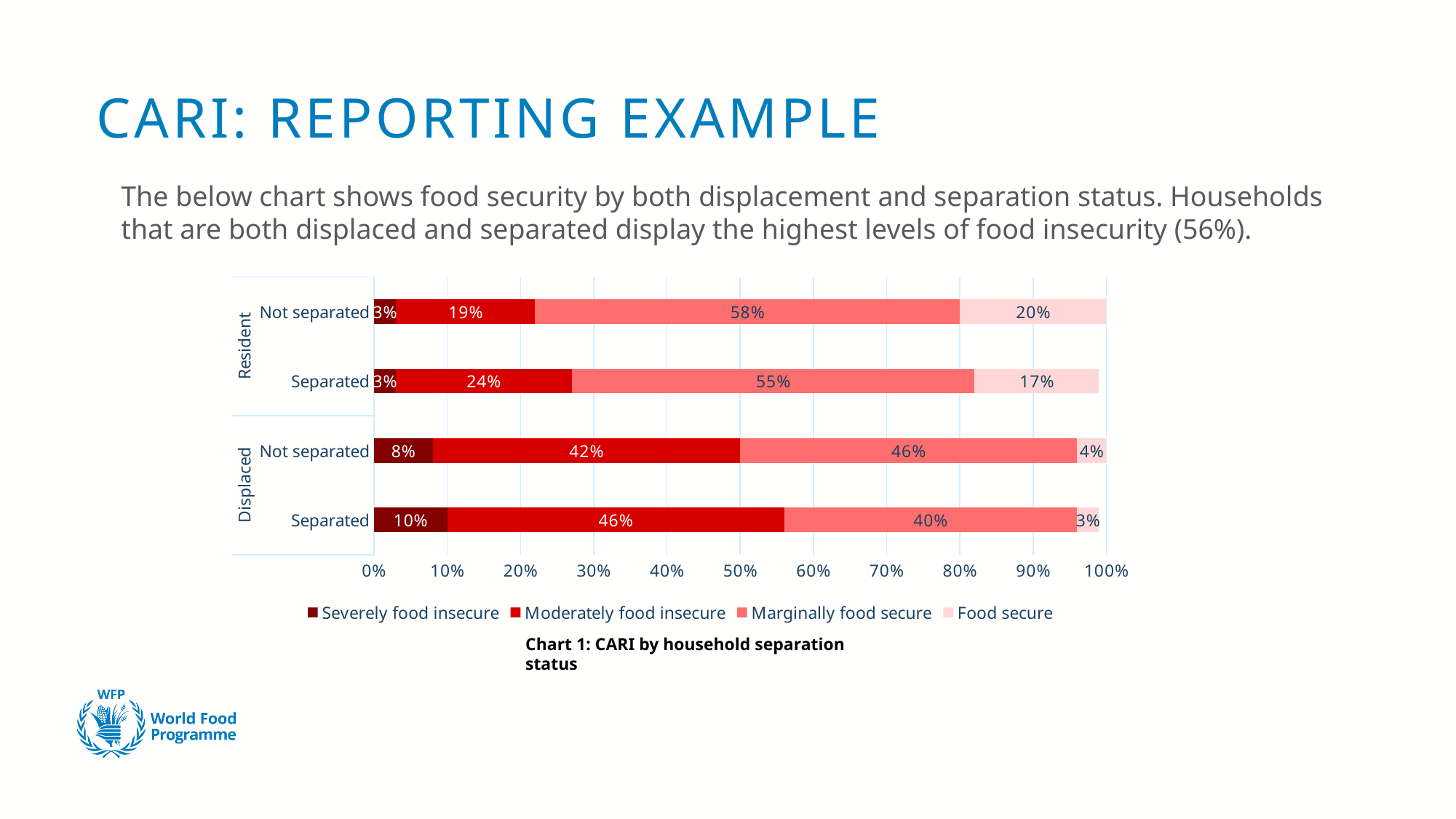
What is the Marginally food secure value for Resident, Not separated households? 58% What is the Severely food insecure value for Displaced, Not separated households? 8% What type of chart is shown on the slide? Stacked bar chart What is the title of the chart? Chart 1: CARI by household separation status How many household groups (bars) are plotted in the chart? 4 Which is larger: the Marginally food secure value for Resident, Separated or for Displaced, Not separated? Resident, Separated Which household group has the lowest Food secure value? Displaced, Separated What is the difference between the Moderately food insecure values for Displaced, Not separated and Resident, Not separated households? 23% How many series does the legend list? 4 What is the Moderately food insecure value for Displaced, Separated households? 46% What is the Food secure value for Resident, Separated households? 17% Which household group has the highest Severely food insecure value? Displaced, Separated